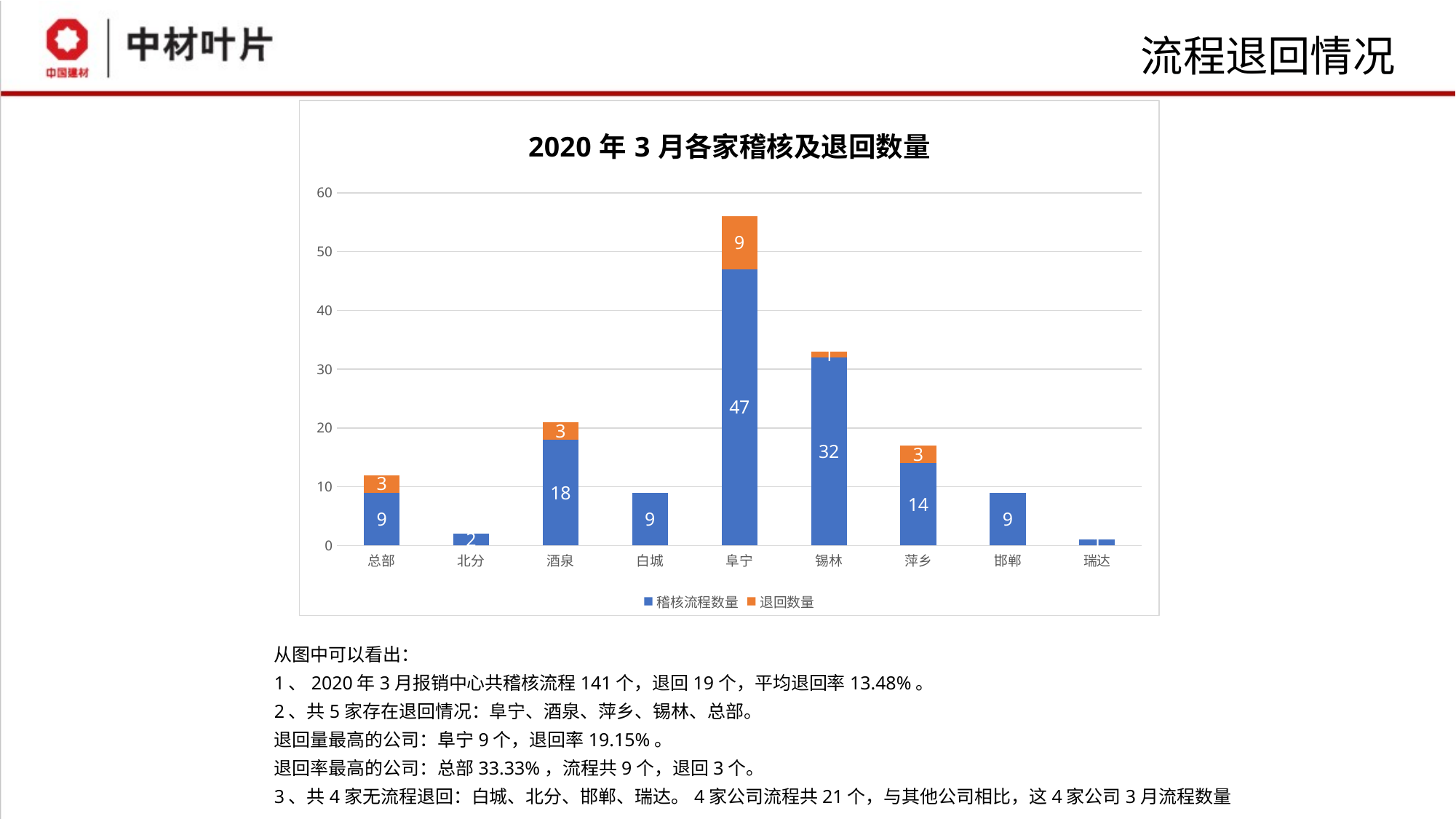
What is the 稽核流程数量 value for 阜宁? 47 What is the total of the stacked bar for 阜宁? 56 What is the difference between the 稽核流程数量 values for 阜宁 and 锡林? 15 Which has the larger 稽核流程数量, 酒泉 or 萍乡? 酒泉 What is the 退回数量 value for 酒泉? 3 Is the total stacked value for 锡林 greater or less than 30? greater What kind of chart is shown on the slide? stacked bar chart How many series does the legend list? 2 How many categories are shown on the x axis? 9 What is the total of the stacked bar for 总部? 12 Which category has the highest 稽核流程数量? 阜宁 What is the 稽核流程数量 value for 萍乡? 14